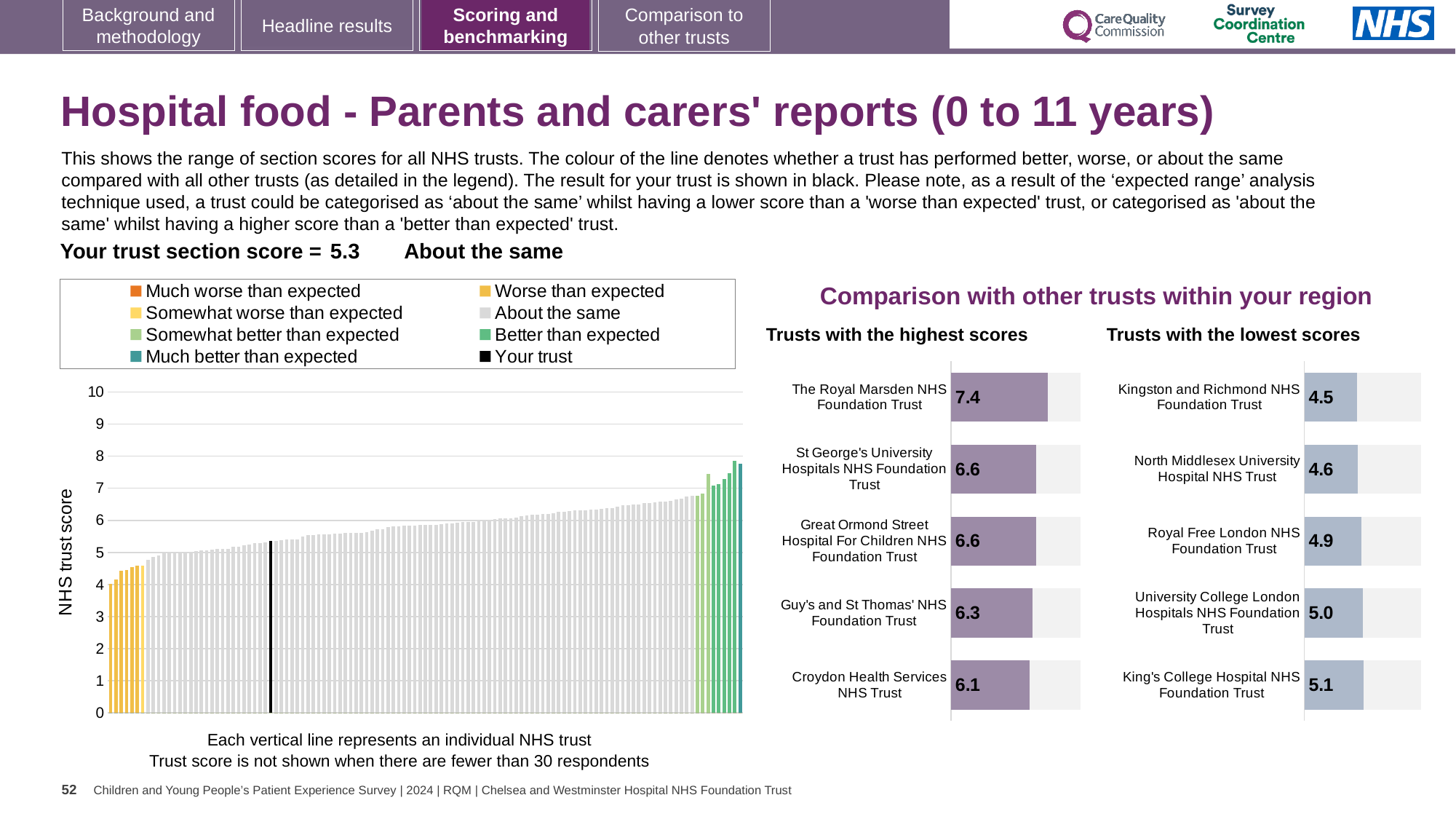
In the main chart on the left showing all NHS trusts, what is the section score for your trust (the black line)? 5.3 In the main chart on the left, do the trust scores rise or fall from left to right? rise In the main chart on the left, is the value of the tallest bar greater or less than 7? greater In the 'Trusts with the highest scores' chart, what is the difference between the scores of The Royal Marsden NHS Foundation Trust and Croydon Health Services NHS Trust? 1.3 In the 'Trusts with the lowest scores' chart, what is the score for Royal Free London NHS Foundation Trust? 4.9 In the 'Trusts with the highest scores' chart, what is the score for The Royal Marsden NHS Foundation Trust? 7.4 How many trusts are listed in the 'Trusts with the lowest scores' chart? 5 Which is larger: the score for Guy's and St Thomas' NHS Foundation Trust in the highest-scores chart or the score for University College London Hospitals NHS Foundation Trust in the lowest-scores chart? Guy's and St Thomas' NHS Foundation Trust In the 'Trusts with the lowest scores' chart, what is the difference between the scores of King's College Hospital NHS Foundation Trust and Kingston and Richmond NHS Foundation Trust? 0.6 In the 'Trusts with the highest scores' chart, which trust has the lowest score shown? Croydon Health Services NHS Trust How many entries does the legend of the main chart on the left list? 8 In the 'Trusts with the lowest scores' chart, which trust has the lowest score? Kingston and Richmond NHS Foundation Trust